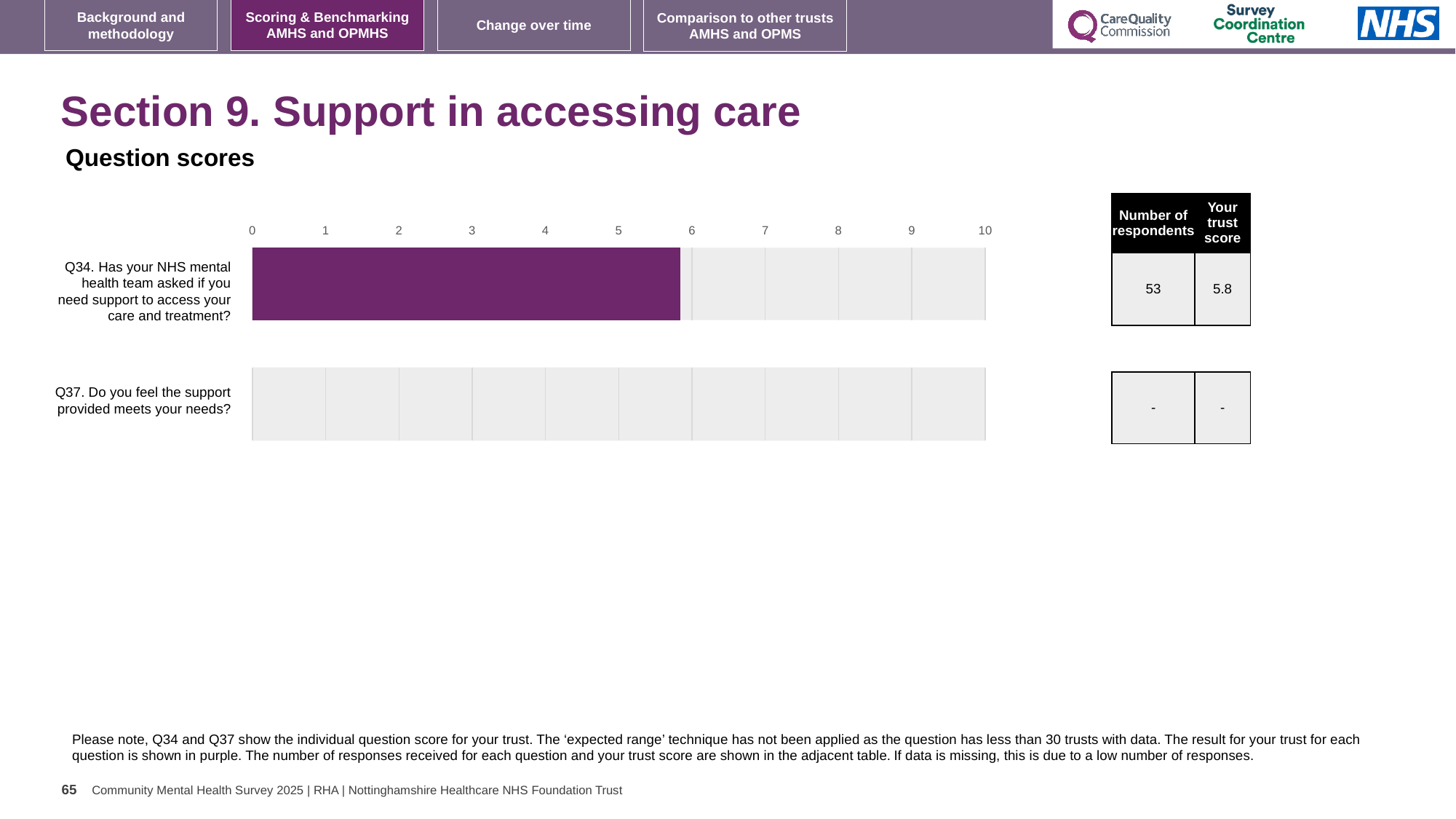
How many questions are listed on the chart? 2 Is the bar for Q34 greater or less than 6 on the axis? less Does the chart show a plotted bar for Q37? No What trust score is shown for Q37 in the table? - Is the bar for Q34 greater or less than 5 on the axis? greater What kind of chart is shown on the slide? Bar chart What colour is used to show the trust's result on the chart? Purple How many respondents answered Q34 according to the table? 53 What is the maximum value shown on the chart's axis? 10 What is the trust score for Q34 shown in the adjacent table? 5.8 Which question has a purple bar plotted on the chart? Q34